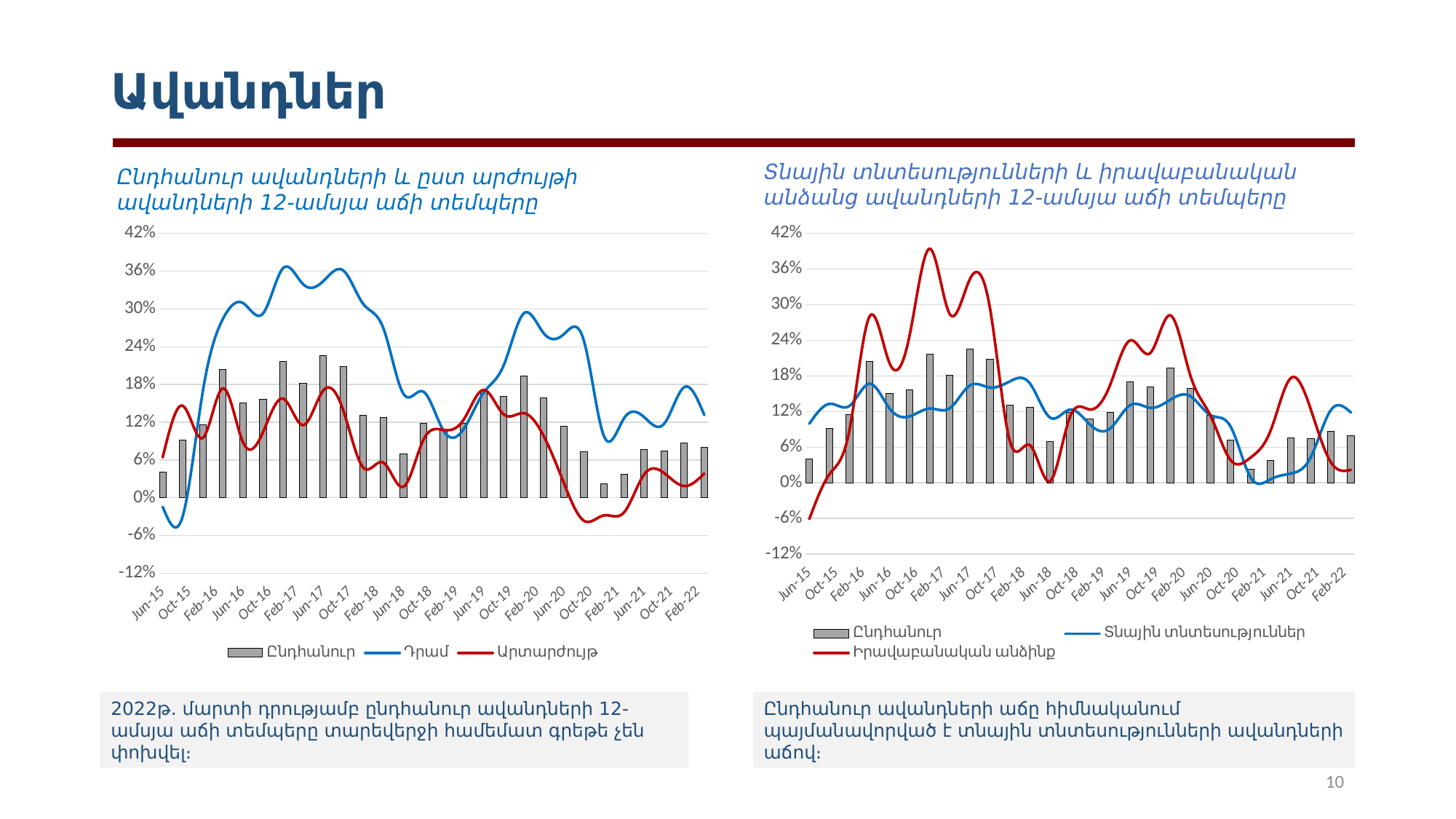
In the right chart, is the value of the Տնային տնտեսություններ line at Feb-21 greater or less than 6%? less In the right chart, is the value of the Իրավաբանական անձինք line at Jun-15 greater or less than 0%? less In the right chart, at which x-axis label does the Իրավաբանական անձինք line reach its highest point? Feb-17 How many series does the legend of the left chart list? 3 In the left chart, is the value of the Արտարժույթ line at Oct-20 greater or less than 0%? less In the left chart, at which x-axis label does the Դրամ line reach its lowest point? Oct-15 In the left chart, which series is drawn as a red line? Արտարժույթ In the right chart, which series is drawn as a blue line? Տնային տնտեսություններ How many series does the legend of the right chart list? 3 What kind of chart is the left chart titled "Ընդհանուր ավանդների և ըստ արժույթի ավանդների 12-ամսյա աճի տեմպերը"? Combined bar and line chart